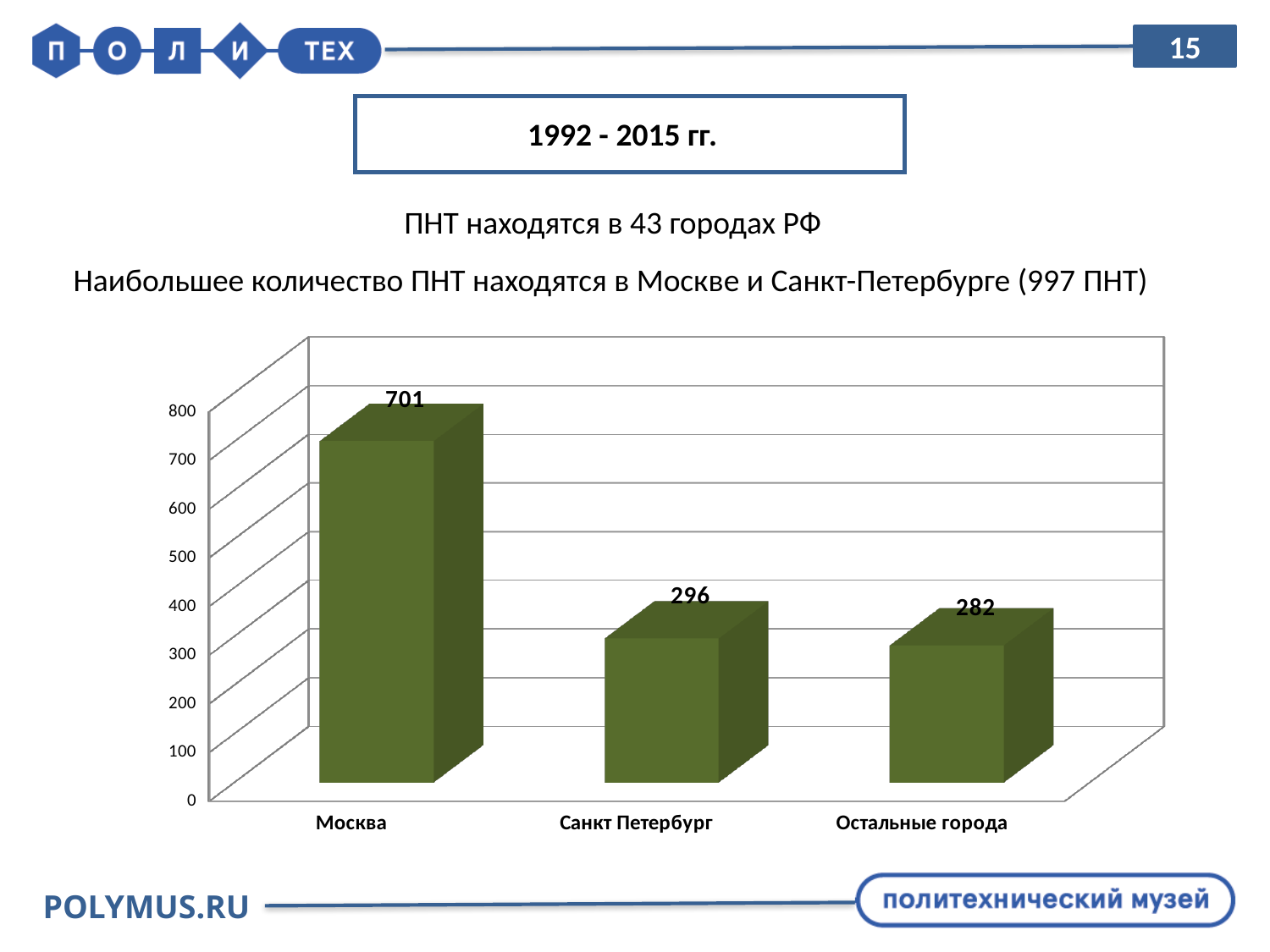
What is the value for Москва? 701 What is the difference between the values for Санкт Петербург and Остальные города? 14 How many categories are shown on the x axis? 3 What kind of chart is shown on the slide? bar chart What is the value for Санкт Петербург? 296 Is the value for Москва greater or less than 600? greater Which category has the highest value? Москва What is the difference between the values for Москва and Санкт Петербург? 405 Which is larger, the value for Москва or the value for Остальные города? Москва What is the highest value shown on the vertical axis? 800 What is the value for Остальные города? 282 Which category has the lowest value? Остальные города